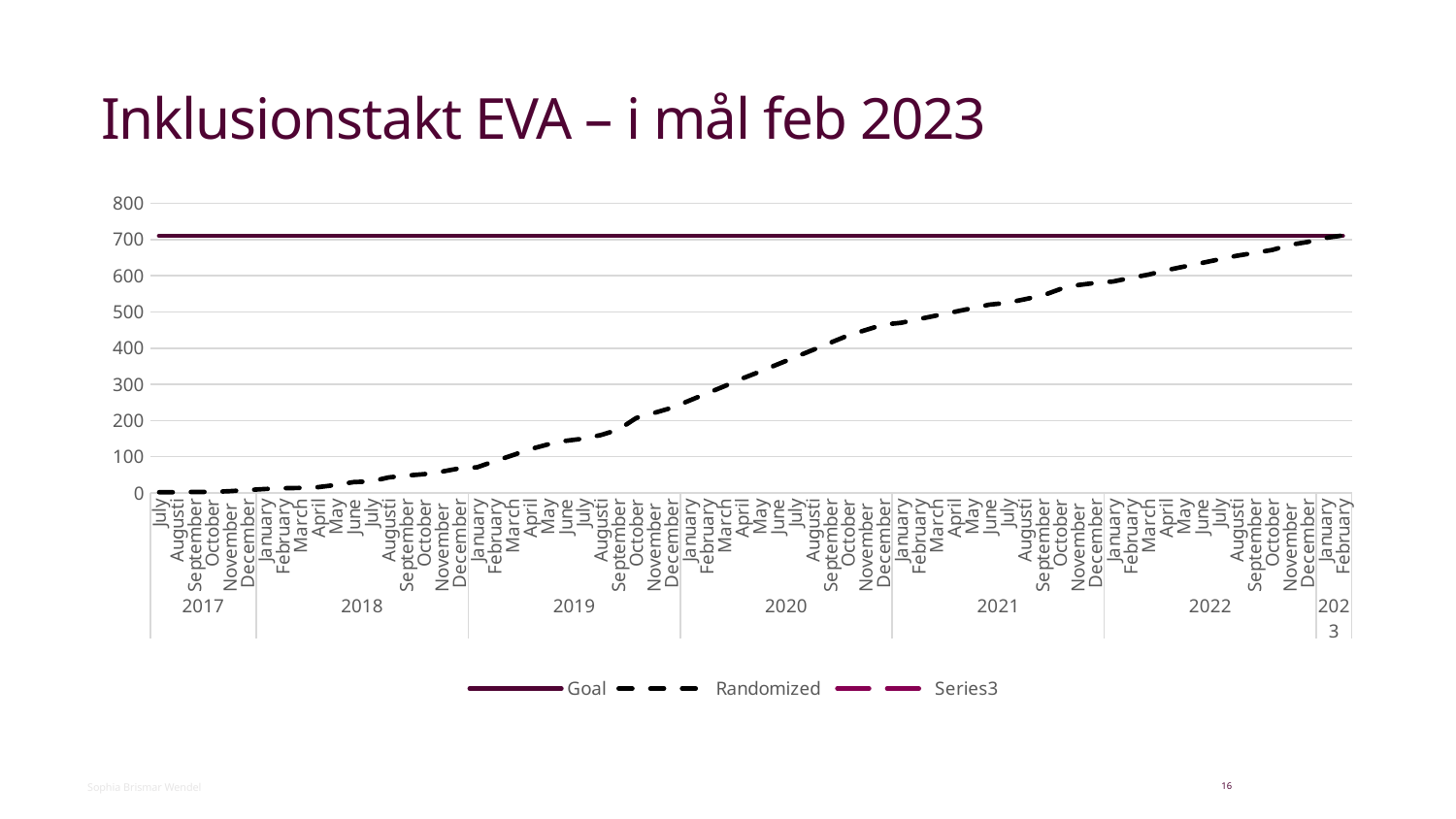
In January 2020, which series has the larger value, Goal or Randomized? Goal Is the Randomized value in July 2020 greater or less than 300? greater Is the Randomized value in July 2022 greater or less than 600? greater What kind of chart is shown on the slide? line chart How many series does the legend list? 3 Is the Goal line greater or less than 600? greater Does the Randomized series rise or fall from July 2017 to February 2023? rise Which series is drawn as a flat horizontal line across the whole chart? Goal What is the title of the chart slide? Inklusionstakt EVA – i mål feb 2023 What is the highest value shown on the y axis? 800